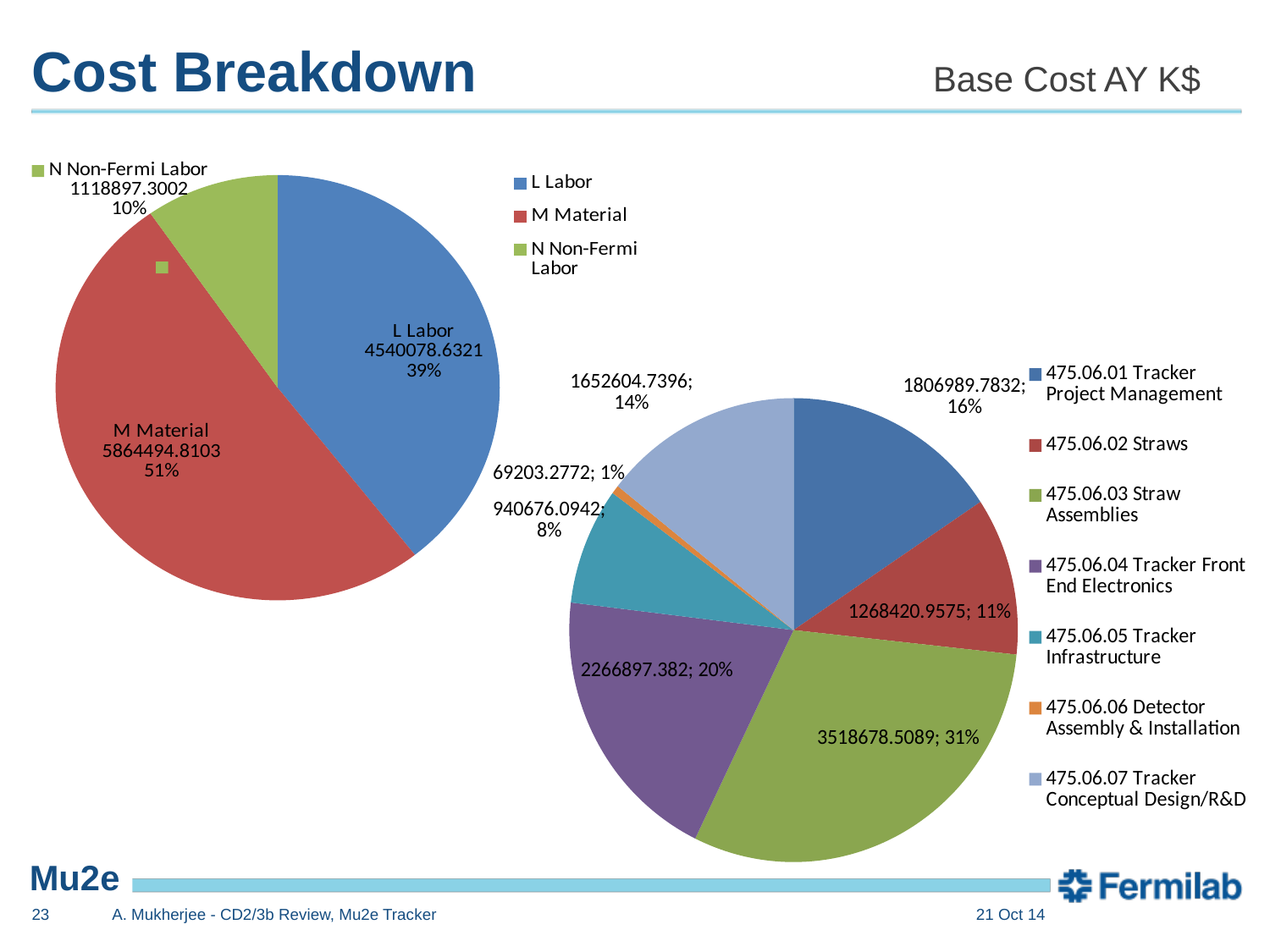
On the right pie chart, which category has the smallest slice? 475.06.06 Detector Assembly & Installation On the right pie chart, what is the value shown for 475.06.04 Tracker Front End Electronics? 2266897.382 On the left pie chart, what is the value shown for L Labor? 4540078.6321 How many categories does the left pie chart show? 3 On the left pie chart, what share does M Material have? 51% On the right pie chart, which is larger: 475.06.01 Tracker Project Management or 475.06.02 Straws? 475.06.01 Tracker Project Management How many categories does the legend of the right pie chart list? 7 On the left pie chart, which category has the smallest slice? N Non-Fermi Labor On the right pie chart, what is the difference in percentage share between 475.06.07 Tracker Conceptual Design/R&D and 475.06.05 Tracker Infrastructure? 6% What type of chart is the chart on the right of the slide? Pie chart On the left pie chart, which category has the largest slice? M Material On the right pie chart, what share does 475.06.03 Straw Assemblies have? 31%